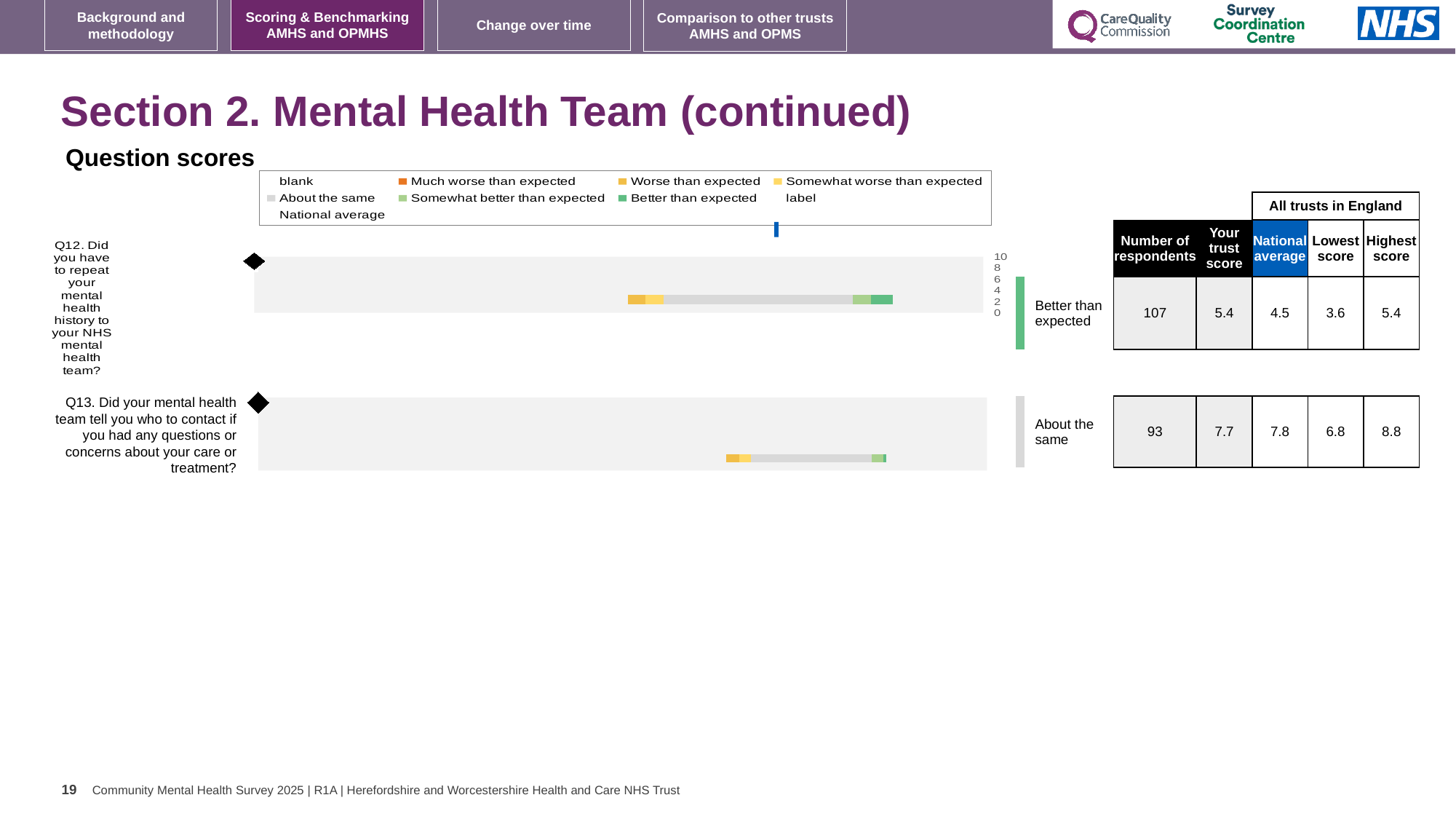
What is the national average for Q13 shown alongside the chart? 7.8 Which question has the higher trust score, Q12 or Q13? Q13 What is the difference between the trust score and the national average for Q12? 0.9 What category label is given to Q12 in the question scores chart? Better than expected What category label is given to Q13 in the question scores chart? About the same How many questions are plotted in the question scores chart? 2 What kind of chart is used to show the question scores on this slide? bar chart How many respondents answered Q12? 107 Which legend entry is shown in orange in the question scores chart? Much worse than expected What is the difference between the highest score for Q13 and the highest score for Q12? 3.4 What is the trust score for Q12 shown alongside the chart? 5.4 What is the highest value shown on the chart's numeric axis? 10